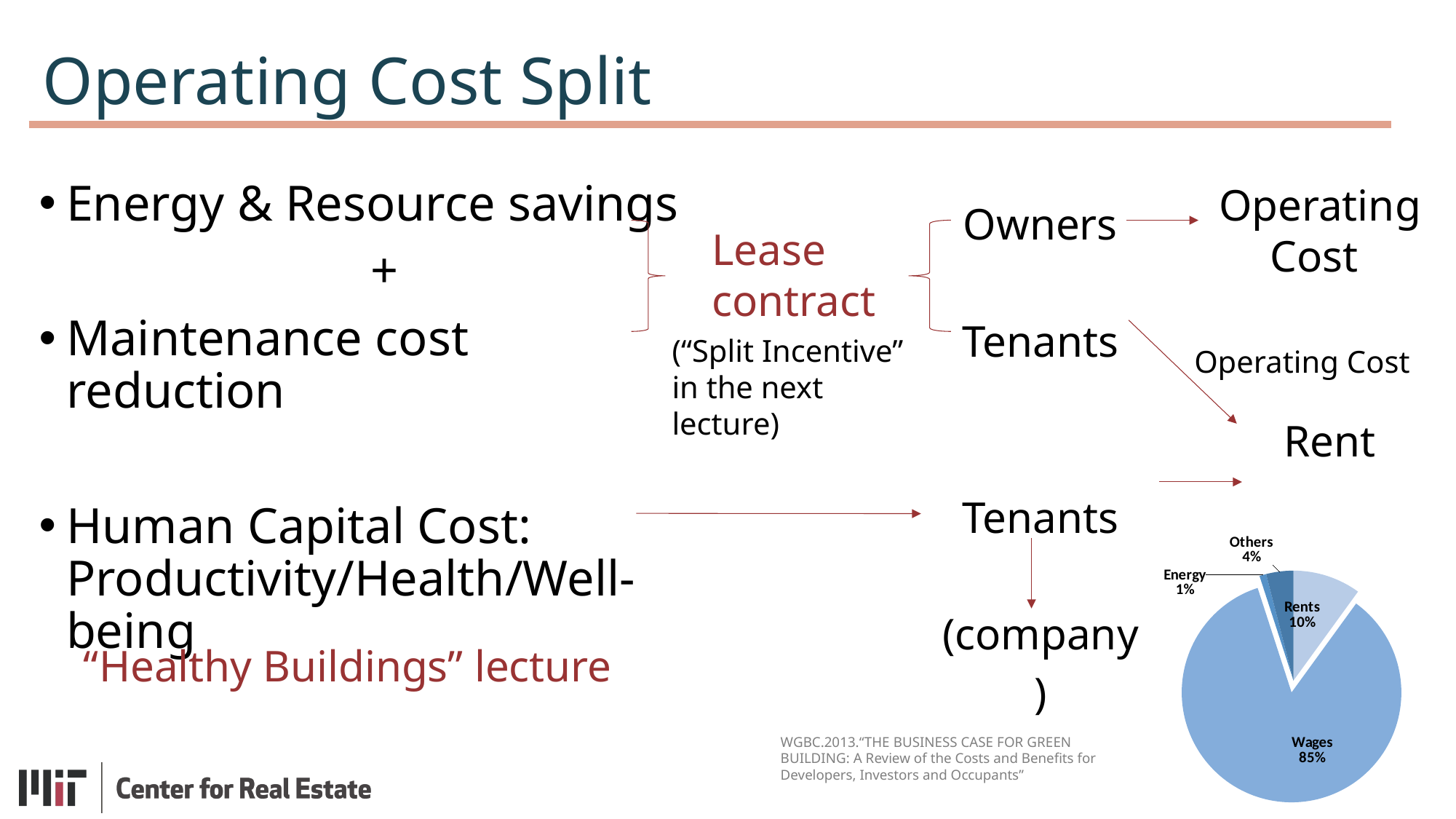
What share of the pie chart is Energy? 1% What is the combined share of Rents and Others in the pie chart? 14% Which slice of the pie chart is pulled out (exploded) from the rest? Rents Which is larger in the pie chart, Others or Energy? Others Which slice of the pie chart is the largest? Wages What kind of chart is shown on the slide? Pie chart What share of the pie chart is Wages? 85% What is the difference in percentage points between the Wages slice and the Rents slice? 75 What share of the pie chart is Others? 4% How many slices does the pie chart have? 4 Which slice of the pie chart is the smallest? Energy What share of the pie chart is Rents? 10%